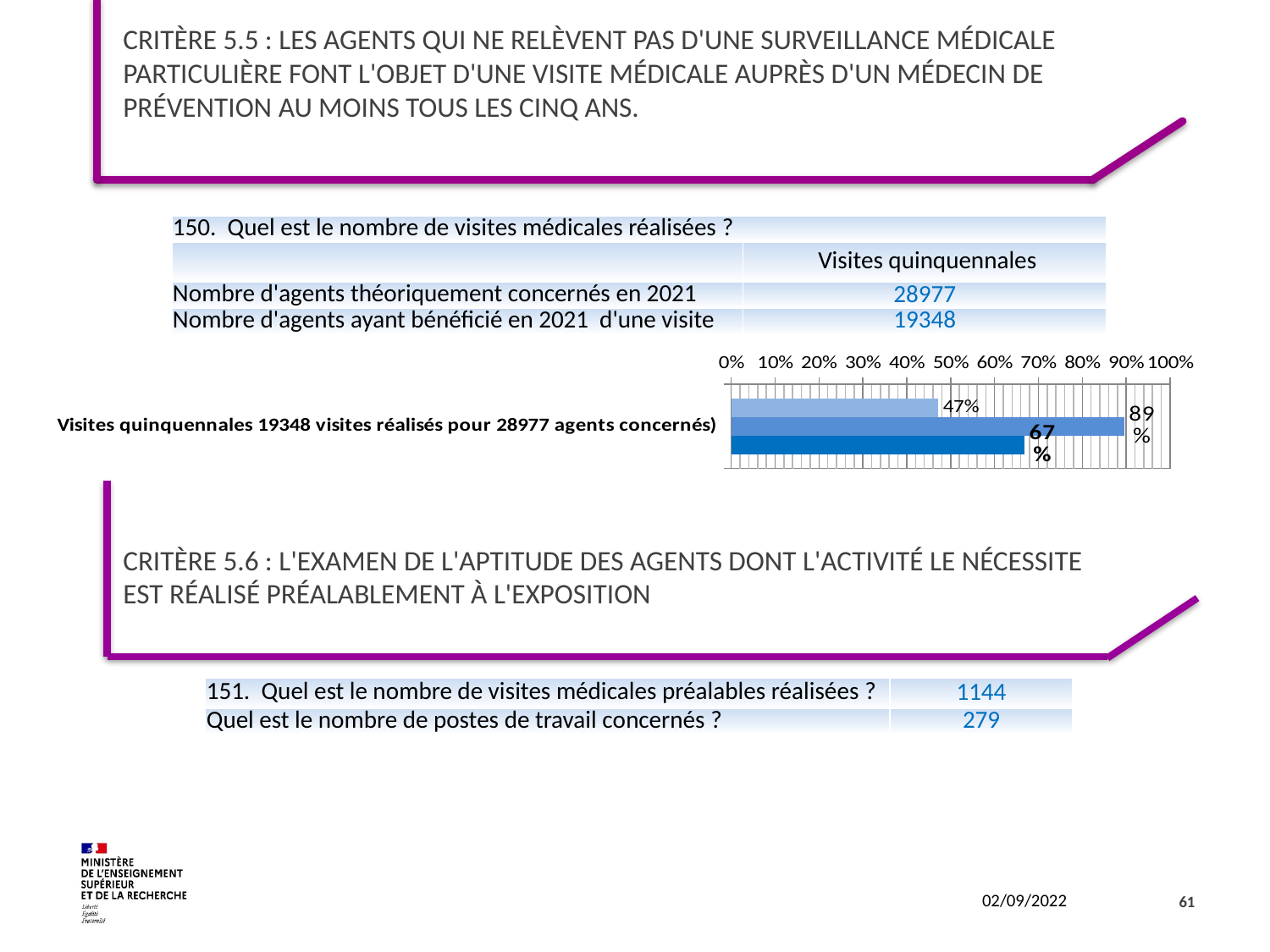
What value is labelled on the bottom (darkest blue) bar of the chart? 67% Which bar in the chart is the shortest: top, middle or bottom? top Which bar in the chart is the longest: top, middle or bottom? middle Is the value of the middle bar greater or less than 80%? greater What is the maximum value shown on the chart's horizontal axis? 100% What kind of chart is shown on the slide? bar chart What is the difference between the middle bar (89%) and the bottom bar (67%)? 22% Which is larger, the top bar or the bottom bar of the chart? bottom bar What value is labelled on the middle bar of the chart? 89% What is the difference between the middle bar (89%) and the top bar (47%)? 42% How many bars are plotted in the chart? 3 What value is labelled on the top (lightest blue) bar of the chart? 47%